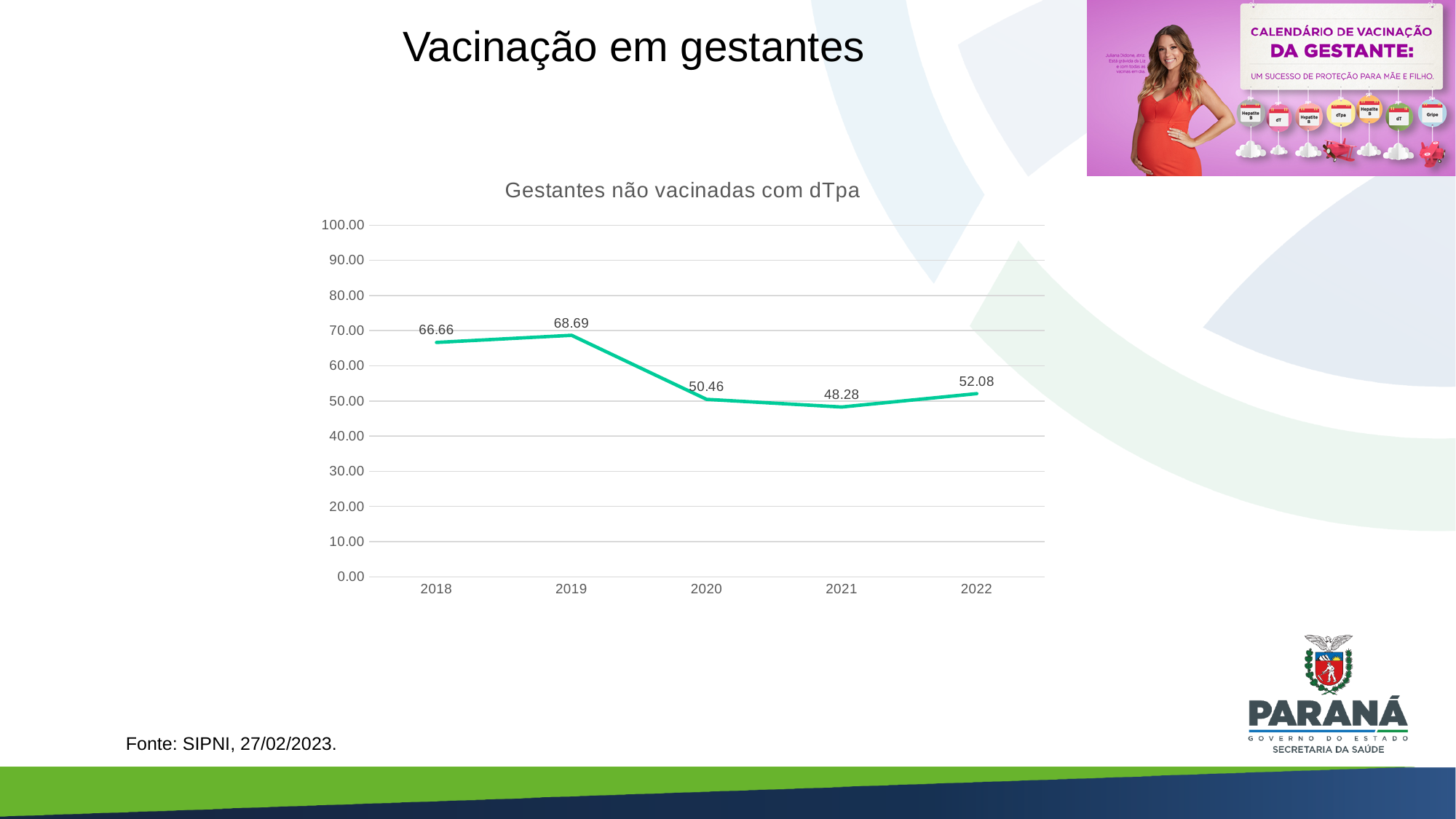
What kind of chart is shown? line chart What is the value for 2022? 52.08 What is the title of the chart? Gestantes não vacinadas com dTpa Which year has the lowest value? 2021 Does the value rise or fall from 2019 to 2021? fall How many years are plotted on the x axis? 5 What is the value for 2021? 48.28 Which year has the highest value? 2019 What is the difference between the values for 2019 and 2020? 18.23 What is the value for 2018? 66.66 Is the value for 2019 greater or less than 60.00? greater Which is larger, the value for 2020 or the value for 2022? 2022